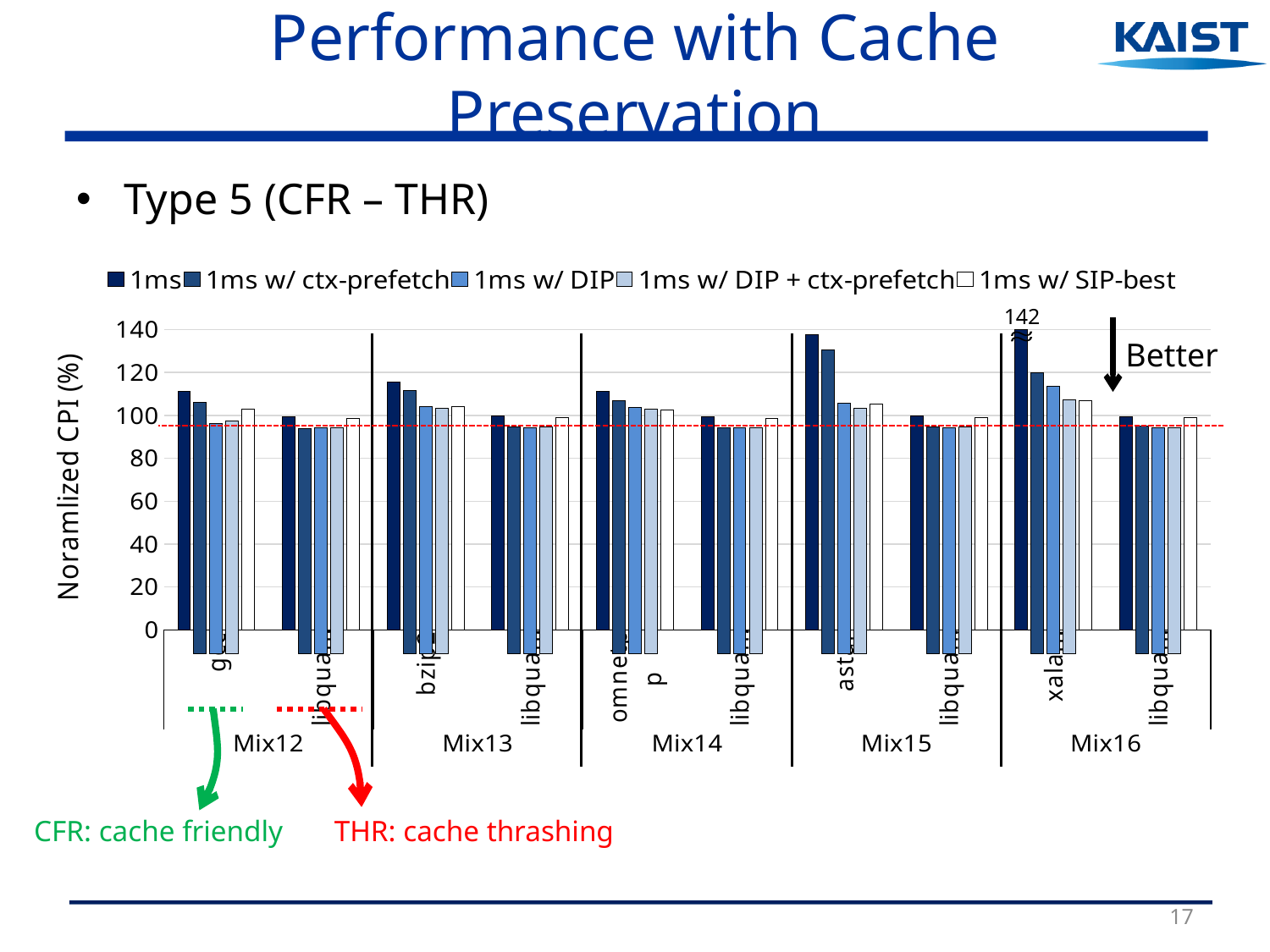
Which is larger: the 1ms bar for astar in Mix15 or the 1ms bar for bzip in Mix13? astar in Mix15 What kind of chart is shown on the slide? bar chart Is the 1ms bar for bzip in Mix13 greater or less than 100? greater Which mix group contains the highest 1ms bar? Mix16 How many series does the legend list? 5 How many mix groups are shown along the x axis? 5 Which series has the highest bar for astar in Mix15? 1ms What is the first entry in the chart legend? 1ms Is the 1ms bar for astar in Mix15 greater or less than 120? greater What value is printed above the 1ms bar for xalan in Mix16? 142 What is the y-axis title of the chart? Noramlized CPI (%) Is the 1ms w/ ctx-prefetch bar for xalan in Mix16 greater or less than 100? greater